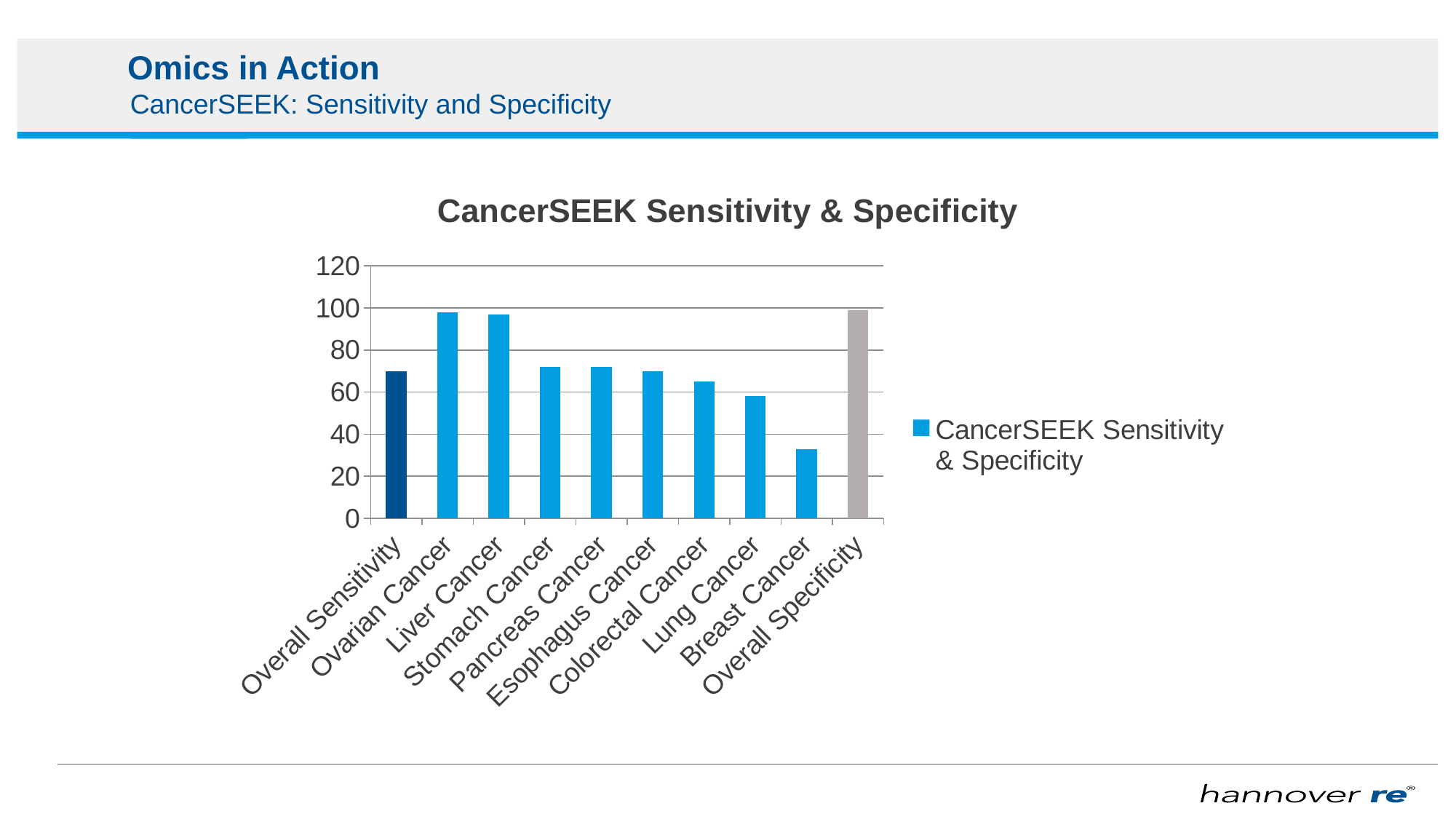
What is the legend entry shown next to the chart? CancerSEEK Sensitivity & Specificity What type of chart is shown on the slide? bar chart Which category has the lowest value? Breast Cancer Is the value for Lung Cancer greater or less than 40? greater How many categories are plotted on the x axis? 10 Is the value for Breast Cancer greater or less than 40? less What is the title of the chart? CancerSEEK Sensitivity & Specificity Which is larger, the value for Lung Cancer or the value for Liver Cancer? Liver Cancer Which is larger, the value for Ovarian Cancer or the value for Breast Cancer? Ovarian Cancer How many series does the legend list? 1 Is the value for Ovarian Cancer greater or less than 80? greater